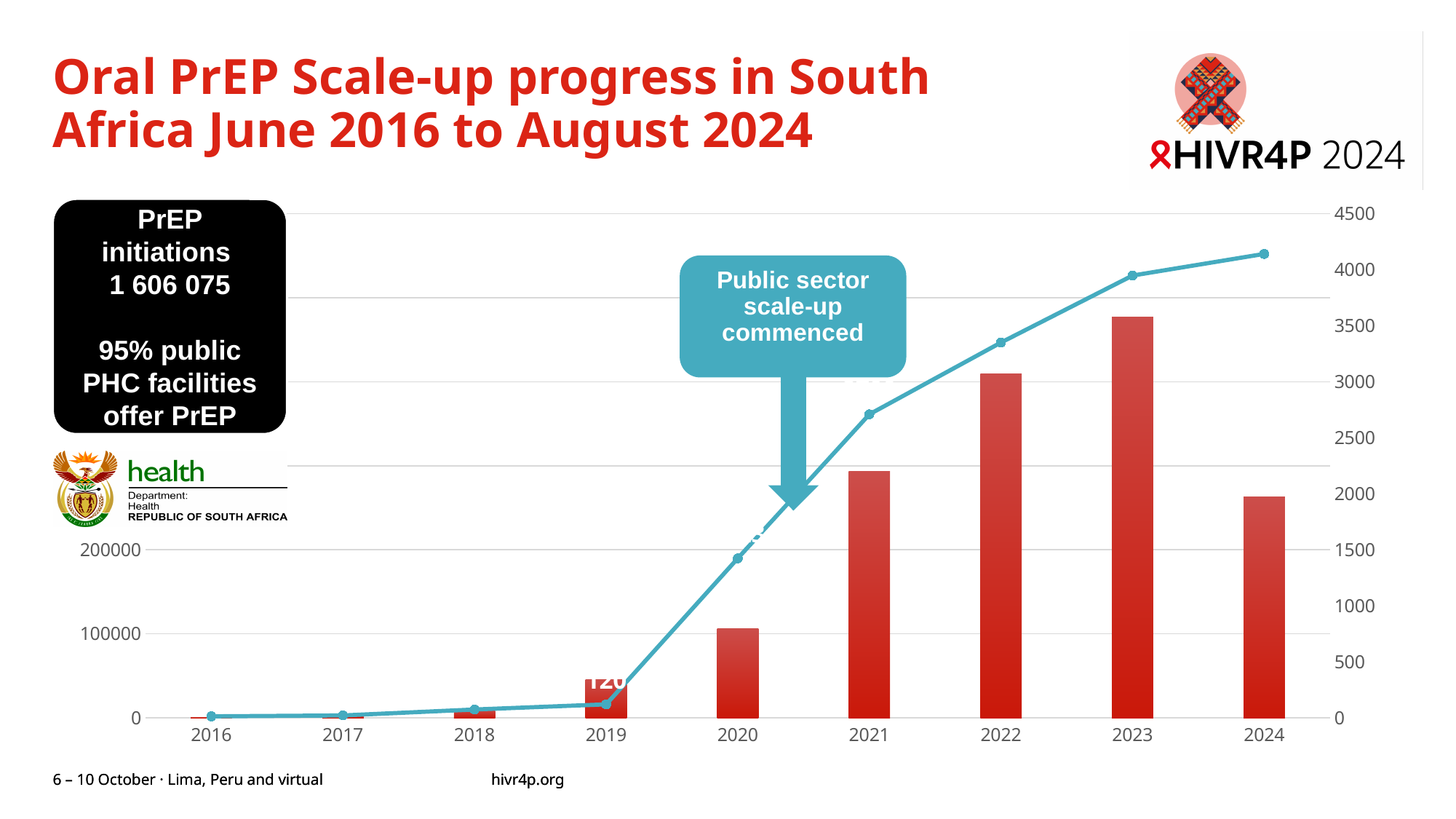
Which year has the shortest bar in the chart? 2016 What does the callout box pointing at the chart say? Public sector scale-up commenced Which year has the tallest bar in the chart? 2023 Is the line value for 2024 greater or less than 4000 on the right axis? greater Which year has the taller bar, 2021 or 2023? 2023 Does the line series rise or fall from 2016 to 2024? Rises Is the bar value for 2021 greater or less than 200000 on the left axis? greater How many years are shown along the x axis of the chart? 9 What kind of chart is shown on the slide? A combined bar and line chart Which year has the taller bar, 2022 or 2024? 2022 Is the line value for 2022 greater or less than 3500 on the right axis? less